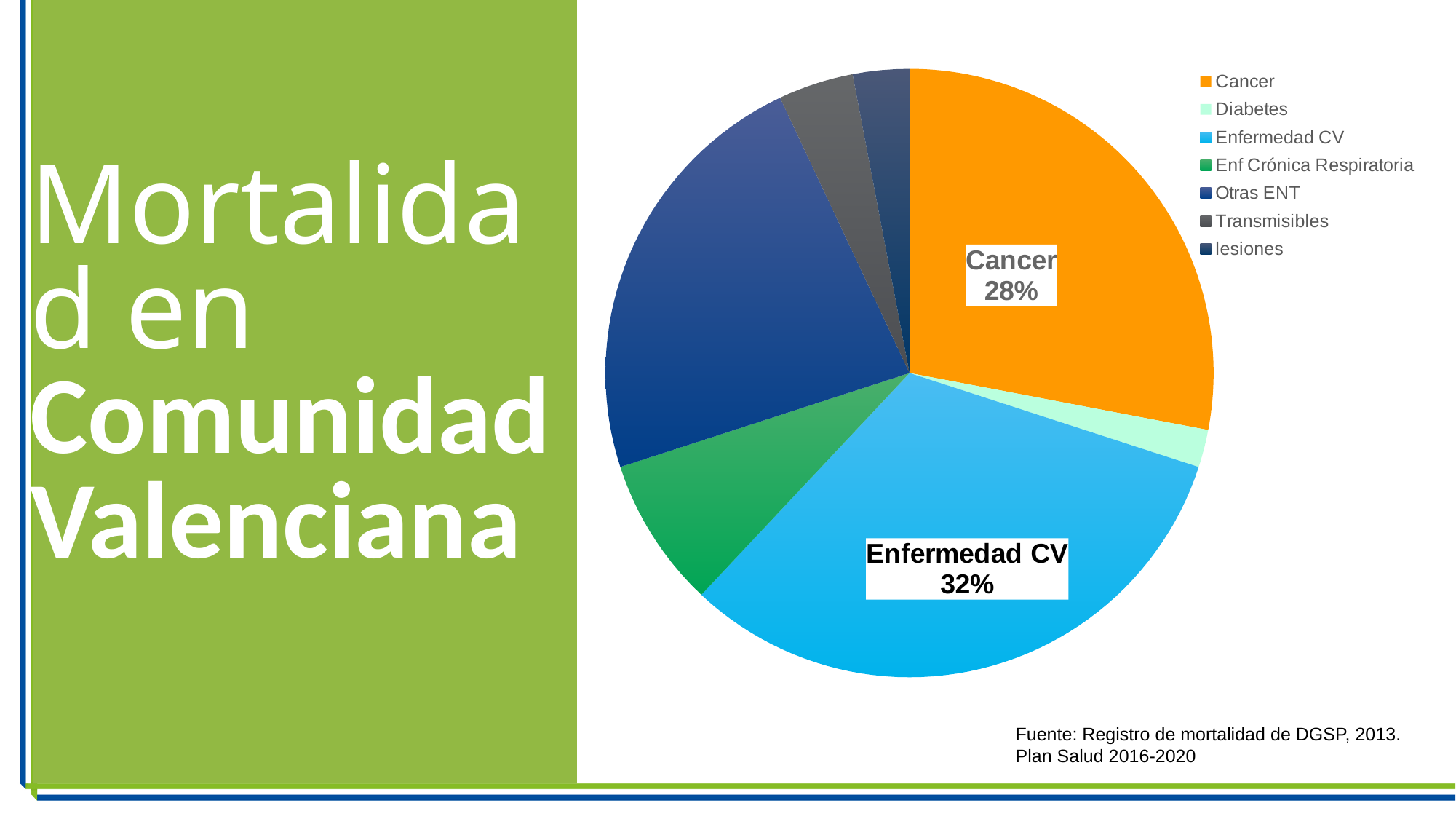
What is the difference in percentage points between the Enfermedad CV share and the Cancer share? 4% What colour is the Cancer slice in the pie chart? Orange How many categories are shown in the pie chart? 7 Which slice is larger, Otras ENT or Enf Crónica Respiratoria? Otras ENT Which category has the largest share of the pie chart? Enfermedad CV What percentage of the pie chart does Enfermedad CV account for? 32% What type of chart is shown on the slide? Pie chart Which is larger, the share for Cancer or the share for Enfermedad CV? Enfermedad CV According to the source note, which registry and year does the mortality data come from? Registro de mortalidad de DGSP, 2013 Which slice is larger, Diabetes or Transmisibles? Transmisibles What percentage of the pie chart does Cancer account for? 28% Which category has the smallest slice of the pie chart? Diabetes